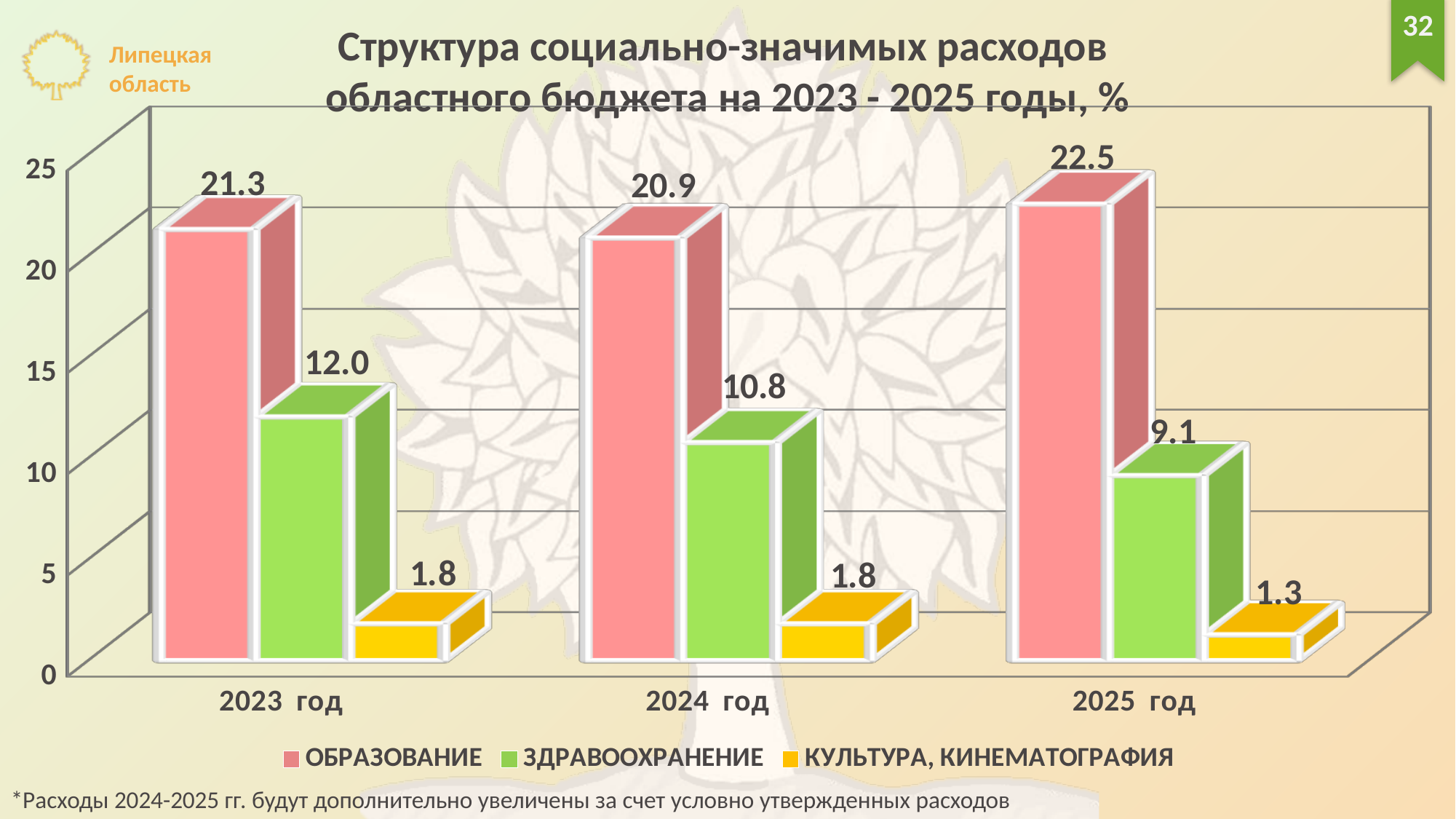
How many years are shown on the x axis? 3 Which is larger: ЗДРАВООХРАНЕНИЕ in 2023 год or ЗДРАВООХРАНЕНИЕ in 2025 год? 2023 год What kind of chart is shown on the slide? Bar chart How many series does the legend list? 3 What is the difference between ОБРАЗОВАНИЕ and ЗДРАВООХРАНЕНИЕ in 2023 год? 9.3 Does the value for ЗДРАВООХРАНЕНИЕ rise or fall from 2023 год to 2025 год? Fall What is the value for КУЛЬТУРА, КИНЕМАТОГРАФИЯ in 2025 год? 1.3 Is the value for ОБРАЗОВАНИЕ in 2024 год greater or less than 20? greater In which year is the value for ЗДРАВООХРАНЕНИЕ lowest? 2025 год What is the value for ЗДРАВООХРАНЕНИЕ in 2024 год? 10.8 In which year is the value for ОБРАЗОВАНИЕ highest? 2025 год What is the value for ОБРАЗОВАНИЕ in 2023 год? 21.3